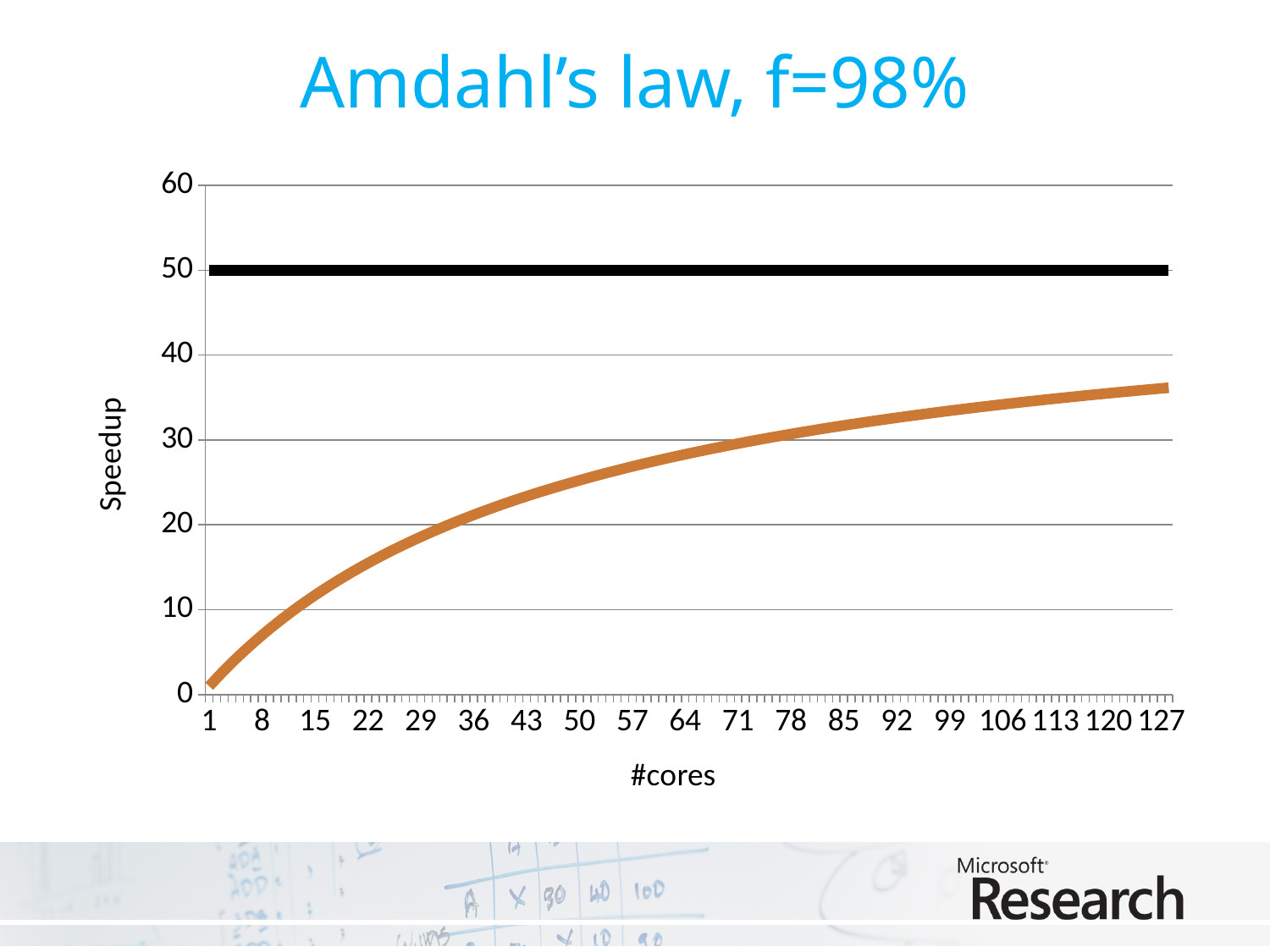
Is the speedup of the orange curve at 1 core greater or less than 10? less At 64 cores, which line shows the higher speedup, the black line or the orange curve? the black line Is the speedup of the orange curve at 99 cores greater or less than 30? greater What kind of chart is shown on the slide? line chart Is the speedup of the orange curve at 50 cores greater or less than 20? greater At what speedup value does the flat black line sit? 50 What is the title of the chart? Amdahl's law, f=98% Does the orange curve rise or fall as the number of cores increases? rises What is the highest value shown on the Speedup axis? 60 What is the label of the vertical axis? Speedup